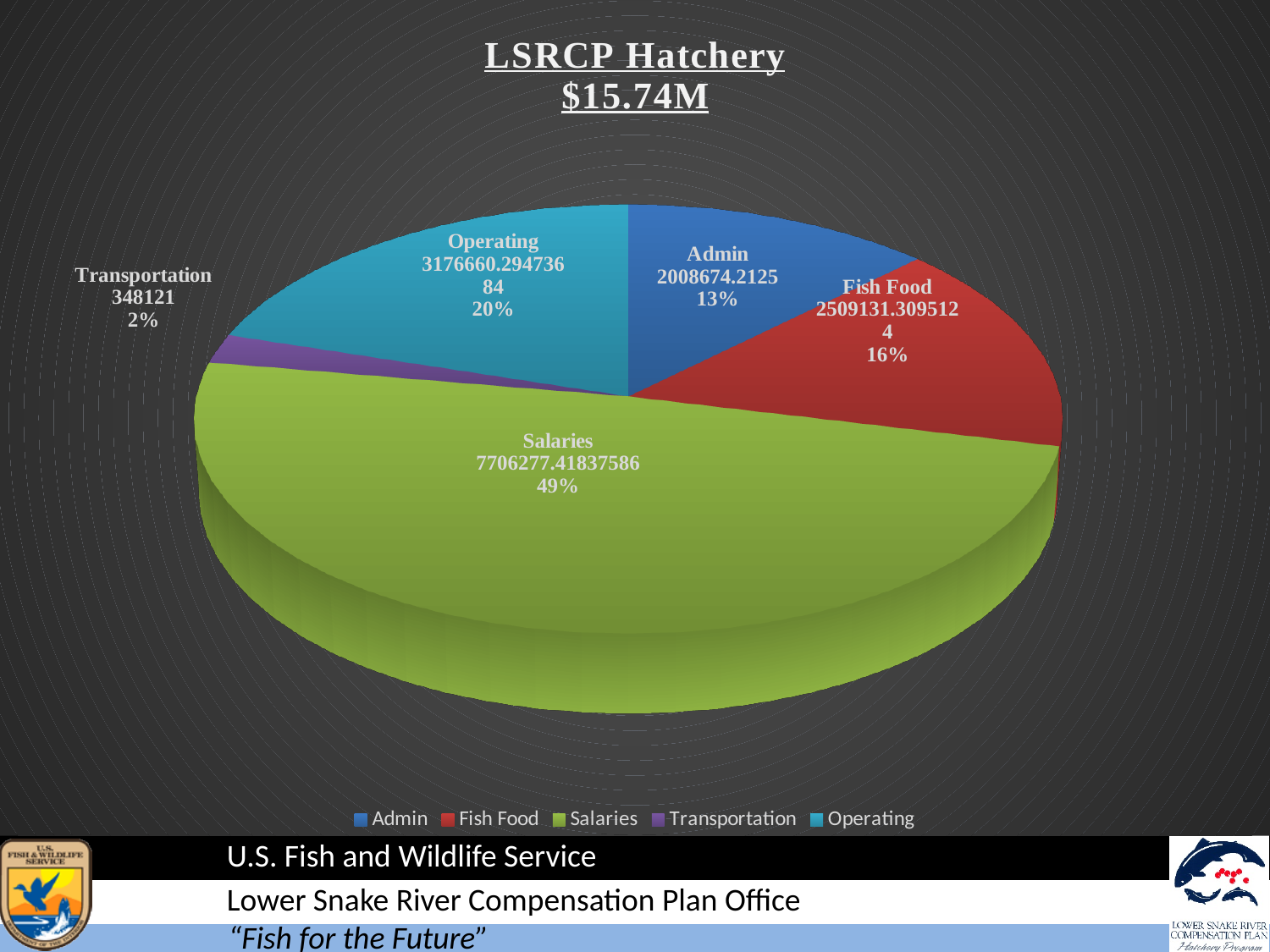
How many entries does the legend list? 5 Which category has the largest slice of the pie? Salaries What is the title of the chart? LSRCP Hatchery $15.74M Which has a larger share of the pie, Admin or Operating? Operating Which category has the smallest slice of the pie? Transportation What percentage share of the pie is Salaries? 49% How many slices does the pie chart have? 5 What kind of chart is shown on the slide? Pie chart What percentage share of the pie is Operating? 20% What is the value shown for Admin? 2008674.2125 What is the value shown for Transportation? 348121 What percentage share of the pie is Fish Food? 16%